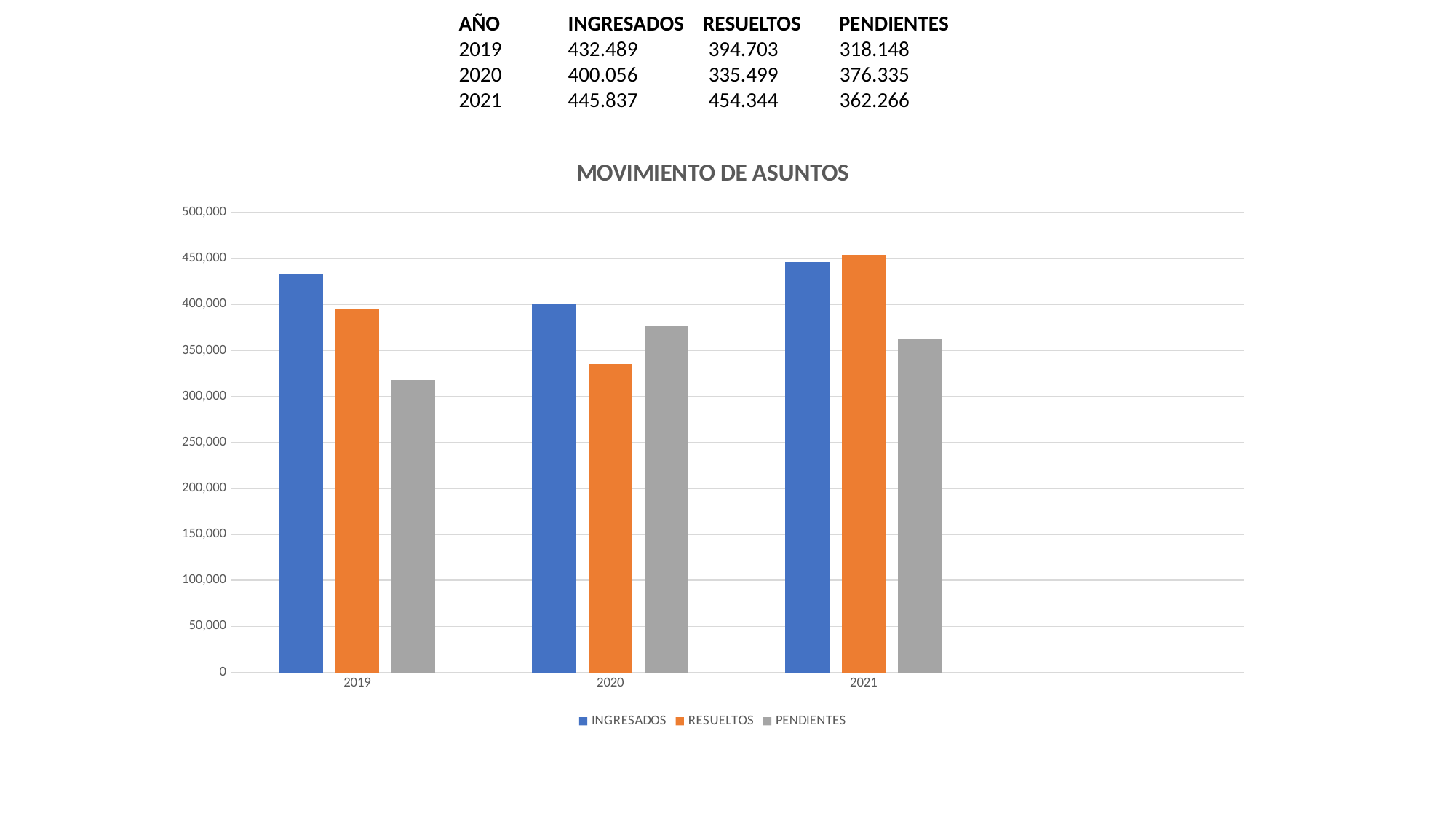
What is the INGRESADOS value for 2019? 432.489 Which year has the lowest RESUELTOS value? 2020 What is the RESUELTOS value for 2021? 454.344 What is the difference between the INGRESADOS values for 2021 and 2019? 13.348 How many series does the legend list? 3 What kind of chart is shown on the slide? bar chart How many years are shown on the x axis of the chart? 3 Which year has the highest PENDIENTES value? 2020 What is the title of the chart? MOVIMIENTO DE ASUNTOS Is the PENDIENTES value for 2019 greater or less than 350,000? less What is the PENDIENTES value for 2020? 376.335 Which is larger in 2020, INGRESADOS or PENDIENTES? INGRESADOS